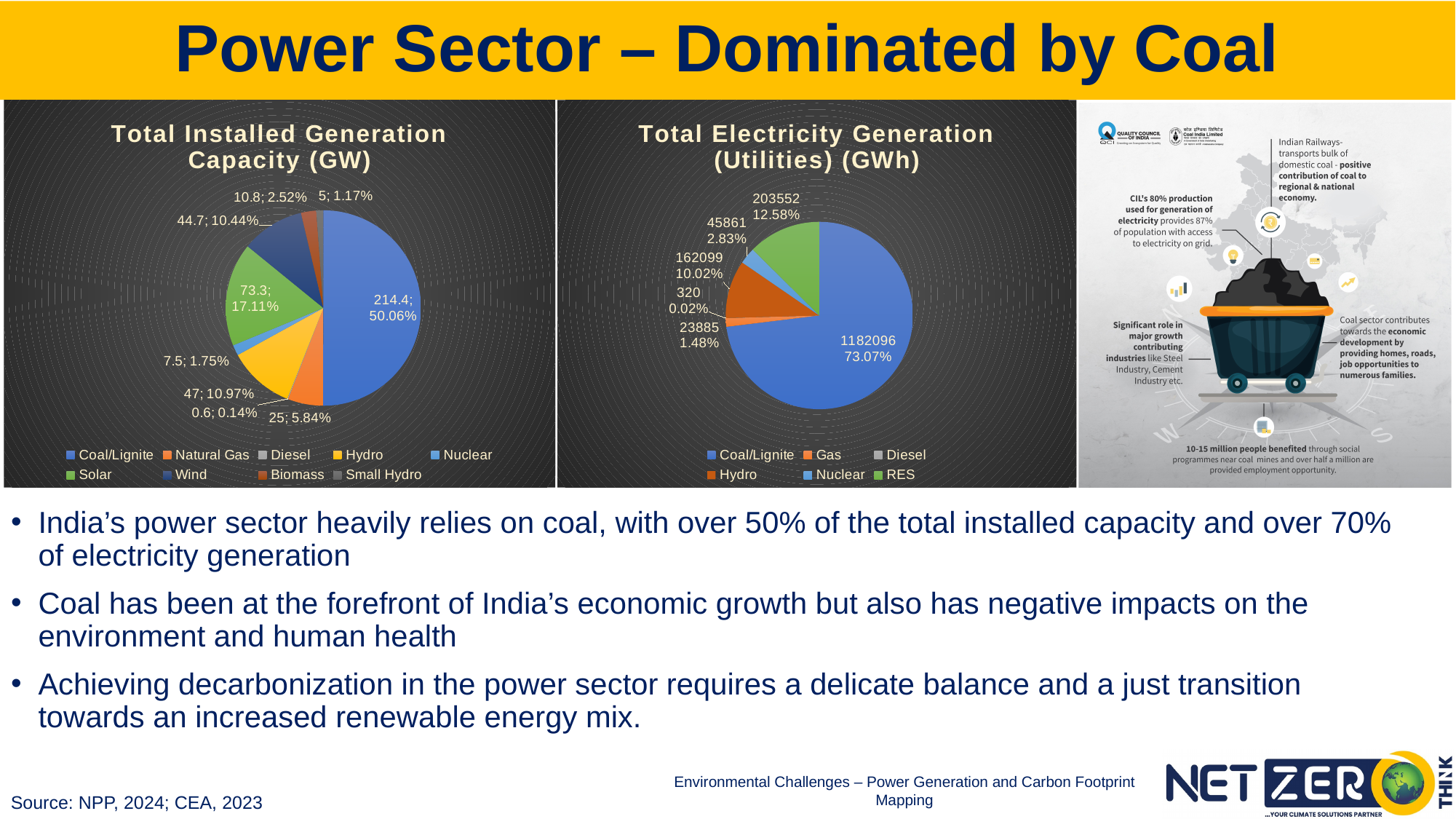
In the Total Installed Generation Capacity (GW) chart, which is larger, Hydro or Wind? Hydro In the Total Installed Generation Capacity (GW) chart, which category has the smallest value? Diesel In the Total Electricity Generation (Utilities) (GWh) chart, how many categories does the legend list? 6 In the Total Electricity Generation (Utilities) (GWh) chart, what percentage share does RES have? 12.58% In the Total Electricity Generation (Utilities) (GWh) chart, which is larger, Hydro or Nuclear? Hydro In the Total Installed Generation Capacity (GW) chart, what share of the pie does Solar represent? 17.11% In the Total Installed Generation Capacity (GW) chart, how many categories does the legend list? 9 In the Total Electricity Generation (Utilities) (GWh) chart, which category has the lowest value? Diesel In the Total Installed Generation Capacity (GW) chart, what is the value for Coal/Lignite? 214.4; 50.06% In the Total Installed Generation Capacity (GW) chart, what is the difference in GW between Solar and Wind? 28.6 In the Total Electricity Generation (Utilities) (GWh) chart, what is the value for Coal/Lignite? 1182096 What type of chart is the Total Electricity Generation (Utilities) (GWh) chart? Pie chart